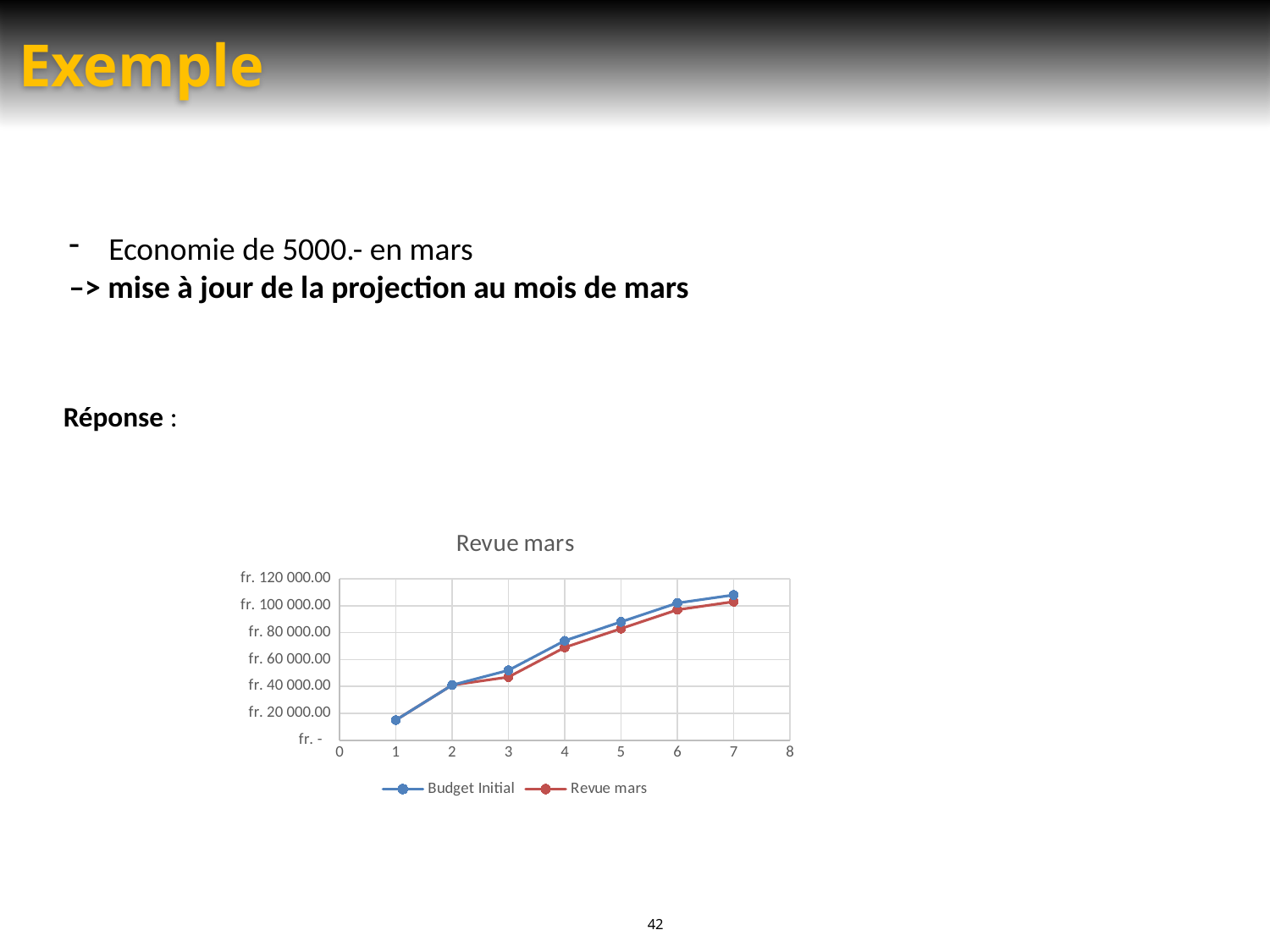
Is the Budget Initial value at x = 7 greater or less than fr. 100 000.00? greater Is the Revue mars value at x = 4 greater or less than fr. 60 000.00? greater Is the Revue mars value at x = 3 greater or less than fr. 60 000.00? less Do the values of the Budget Initial series rise or fall as the x axis goes from 1 to 7? rise How many data points are plotted for the Budget Initial series? 7 What kind of chart is shown under the title "Revue mars"? line chart How many series does the legend of the "Revue mars" chart list? 2 What is the title of the chart on the slide? Revue mars At x = 7, which series has the higher value, Budget Initial or Revue mars? Budget Initial What are the two series named in the legend of the chart? Budget Initial and Revue mars